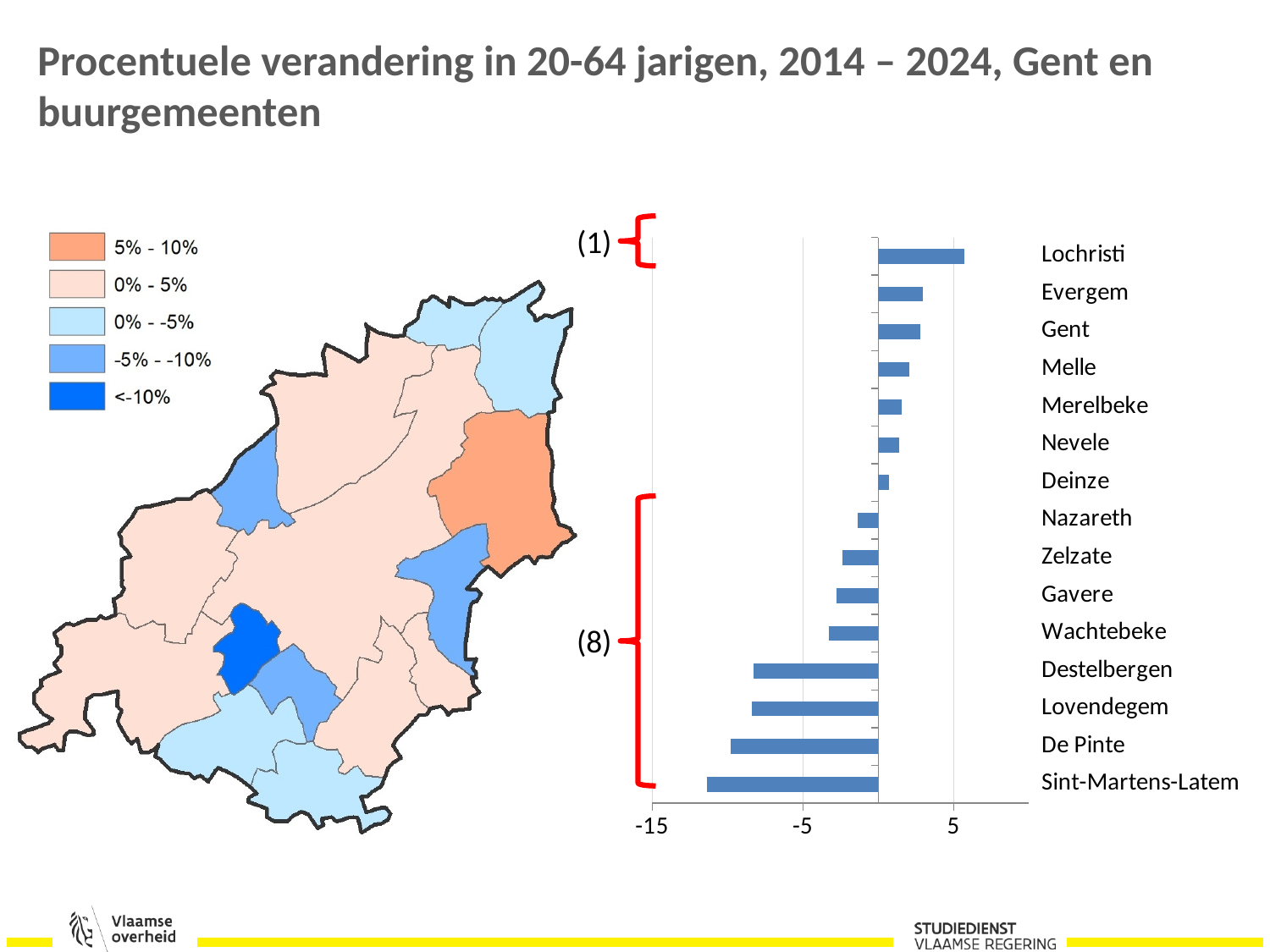
Which has the larger value, Lochristi or Gent? Lochristi How many municipalities are listed in the bar chart? 15 Is the value for Destelbergen greater or less than -5? less Which municipality has the highest value in the bar chart? Lochristi Is the value for Lochristi greater or less than 5? greater Is the value for Nazareth greater or less than -5? greater What kind of chart is shown on the right side of the slide? bar chart Which municipality has the lowest value in the bar chart? Sint-Martens-Latem Which has the larger value, Nazareth or De Pinte? Nazareth How many colour classes does the map legend list? 5